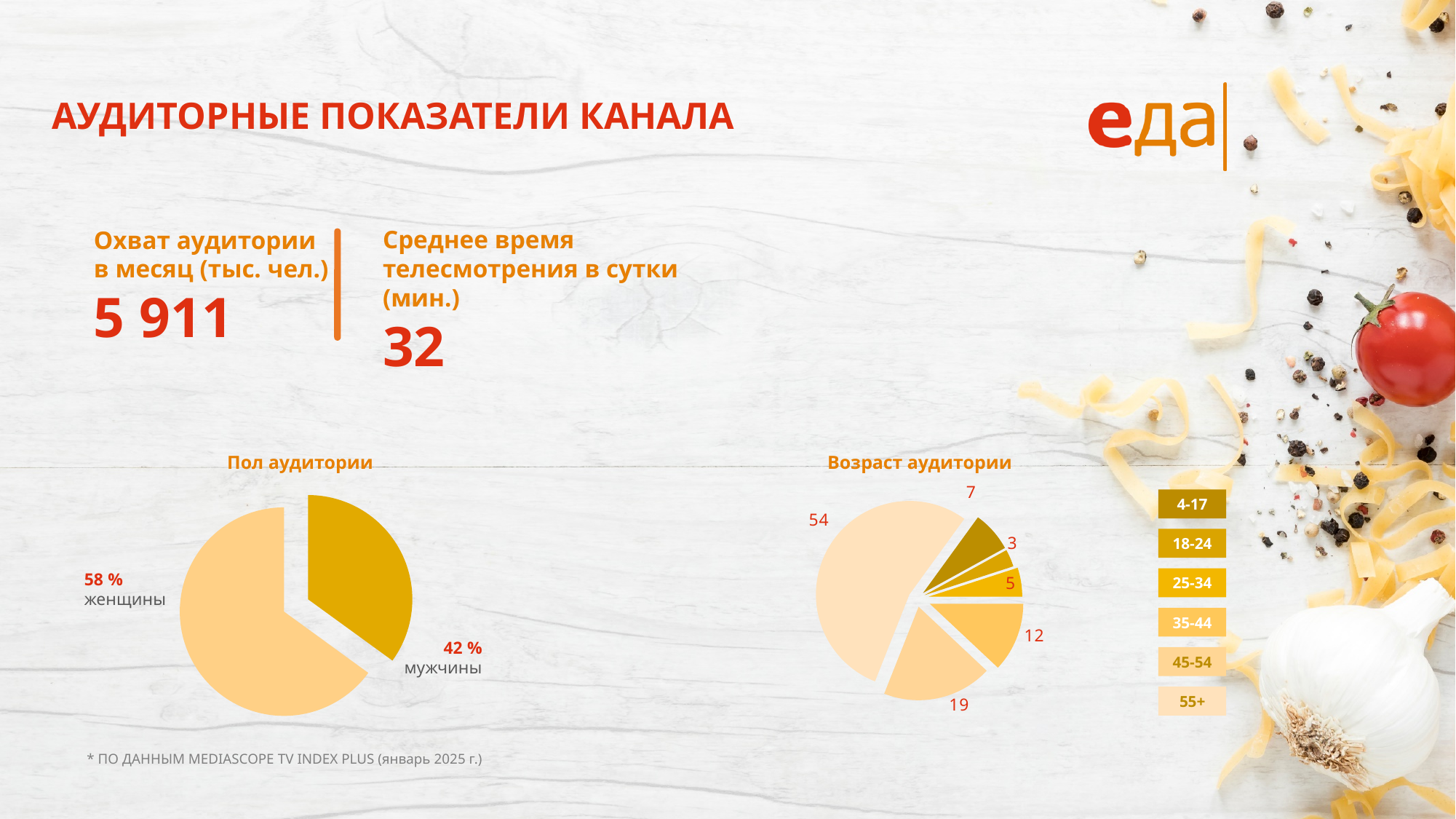
How many age groups does the legend of the 'Возраст аудитории' chart list? 6 In the 'Возраст аудитории' chart, what is the value for the 55+ age group? 54 In the 'Пол аудитории' chart, what is the difference in percentage points between женщины and мужчины? 16 In the 'Возраст аудитории' chart, what is the value for the 18-24 age group? 3 In the 'Возраст аудитории' chart, which age group has the smallest share? 18-24 In the 'Возраст аудитории' chart, which age group has the largest share? 55+ What kind of chart is 'Пол аудитории'? pie chart In the 'Пол аудитории' chart, what share of the audience is женщины? 58 % In the 'Возраст аудитории' chart, what is the value for the 45-54 age group? 19 In the 'Пол аудитории' chart, which group has the larger share, женщины or мужчины? женщины In the 'Пол аудитории' chart, what share of the audience is мужчины? 42 % In the 'Возраст аудитории' chart, what is the difference between the values for 35-44 and 4-17? 5